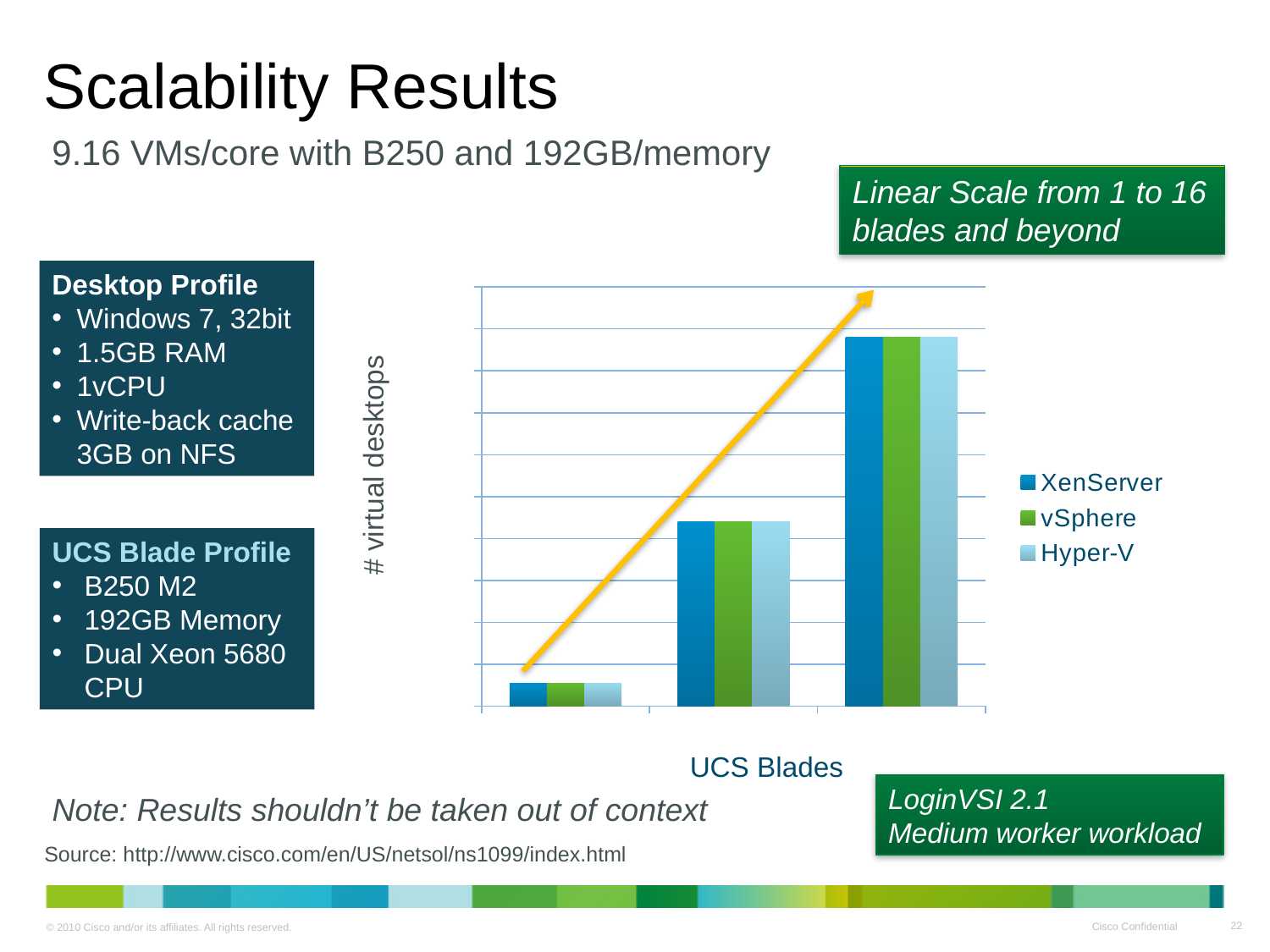
How many groups of bars are plotted on the chart? 3 Which group of bars is the shortest: the first, second or third from the left? first Are the bars in the rightmost group taller or shorter than the bars in the middle group? taller Are the bars in the leftmost group taller or shorter than the bars in the middle group? shorter What kind of chart is shown on the slide? bar chart How many series does the chart legend list? 3 Do the bar heights rise or fall from left to right along the x axis? rise What is the label of the chart's vertical axis? # virtual desktops Which group of bars is the tallest: the first, second or third from the left? third Which series are listed in the chart legend? XenServer, vSphere, Hyper-V